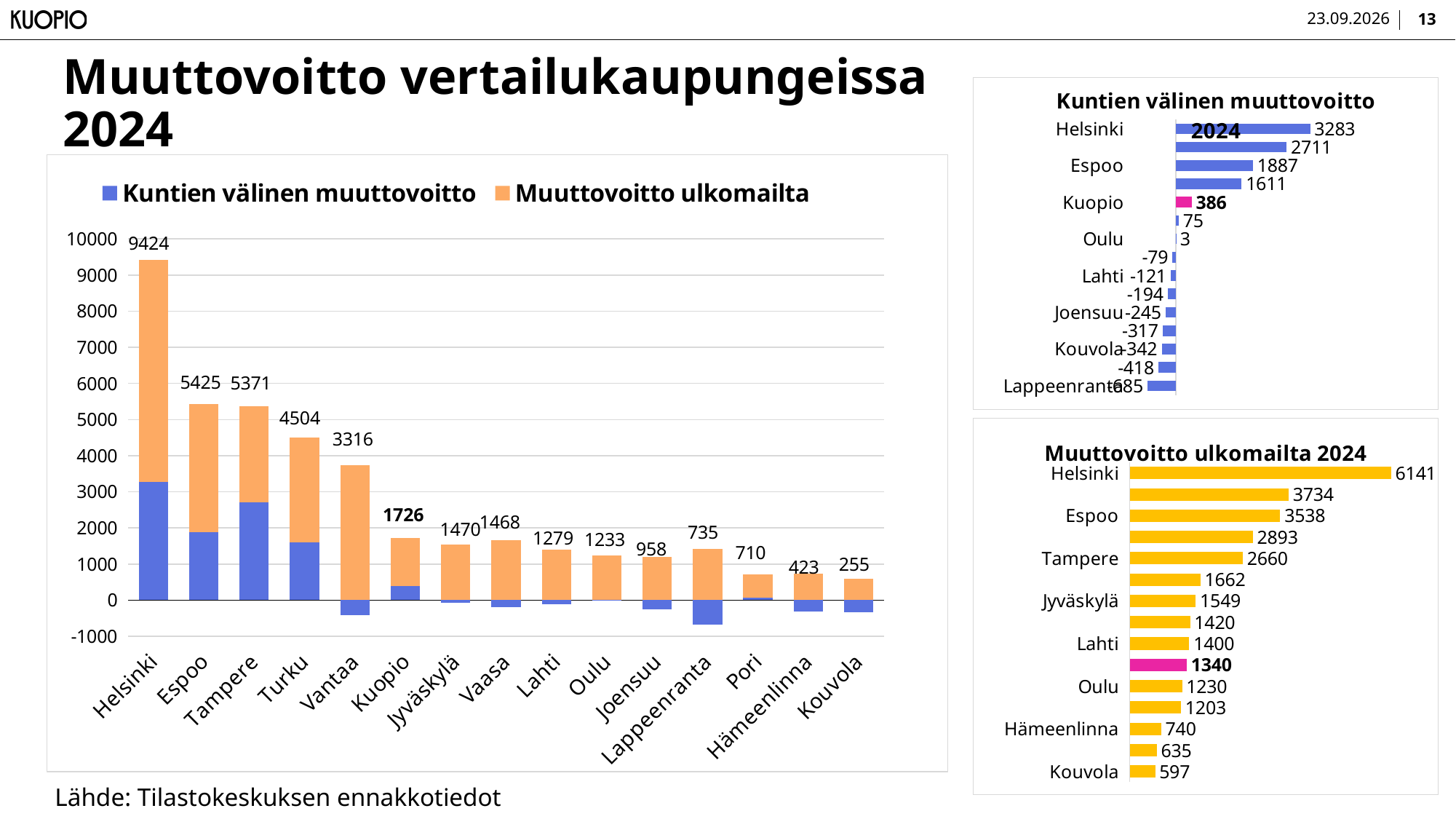
In the chart titled 'Muuttovoitto ulkomailta 2024', what is the value for Helsinki? 6141 In the chart titled 'Kuntien välinen muuttovoitto 2024', what is the value for Lappeenranta? -685 In the main stacked bar chart, what is the total value labelled for Kuopio? 1726 In the main stacked bar chart, what is the difference between the totals for Espoo and Tampere? 54 In the chart titled 'Kuntien välinen muuttovoitto 2024', what is the value for Kuopio? 386 What kind of chart is the chart titled 'Muuttovoitto ulkomailta 2024'? Bar chart In the main stacked bar chart, which city has the lowest total? Kouvola In the main stacked bar chart, what is the total value labelled for Helsinki? 9424 In the main stacked bar chart, how many cities are shown on the x axis? 15 In the main stacked bar chart, how many series does the legend list? 2 In the main stacked bar chart, is the total for Turku greater or less than 4000? greater In the chart titled 'Muuttovoitto ulkomailta 2024', which is larger, the value for Espoo or the value for Tampere? Espoo